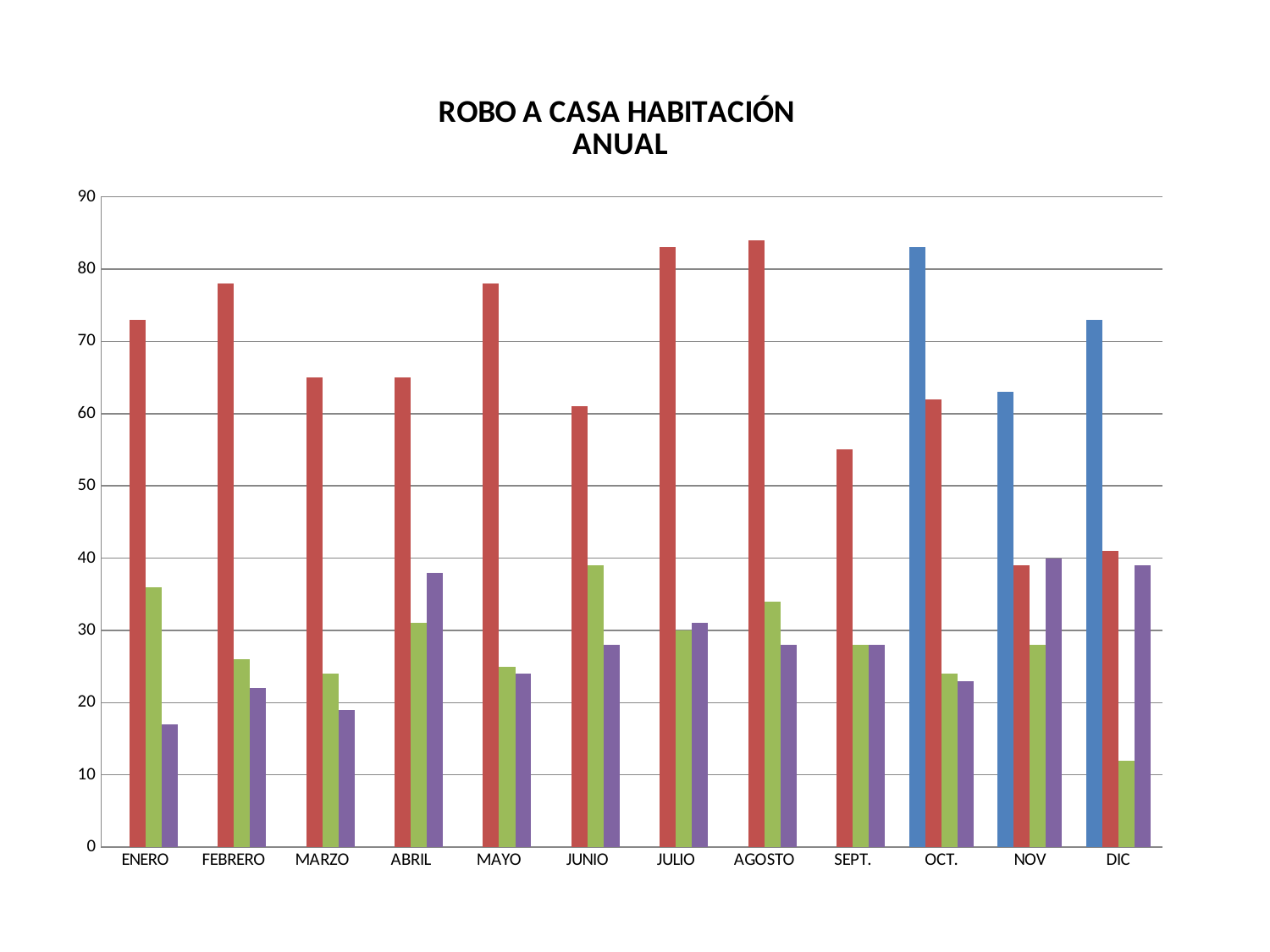
What is the title of the chart? ROBO A CASA HABITACIÓN ANUAL Is the red bar for ENERO greater or less than 70? greater Which month has the shortest green bar? DIC Which is larger, the red bar for ENERO or the red bar for MARZO? ENERO Is the green bar for JUNIO greater or less than 30? greater Is the green bar for DIC greater or less than 20? less Which months have a blue bar in the chart? OCT., NOV, DIC Which is larger, the blue bar for OCT. or the blue bar for NOV? OCT. How many months are shown on the x axis of the chart? 12 What kind of chart is shown on the slide? bar chart